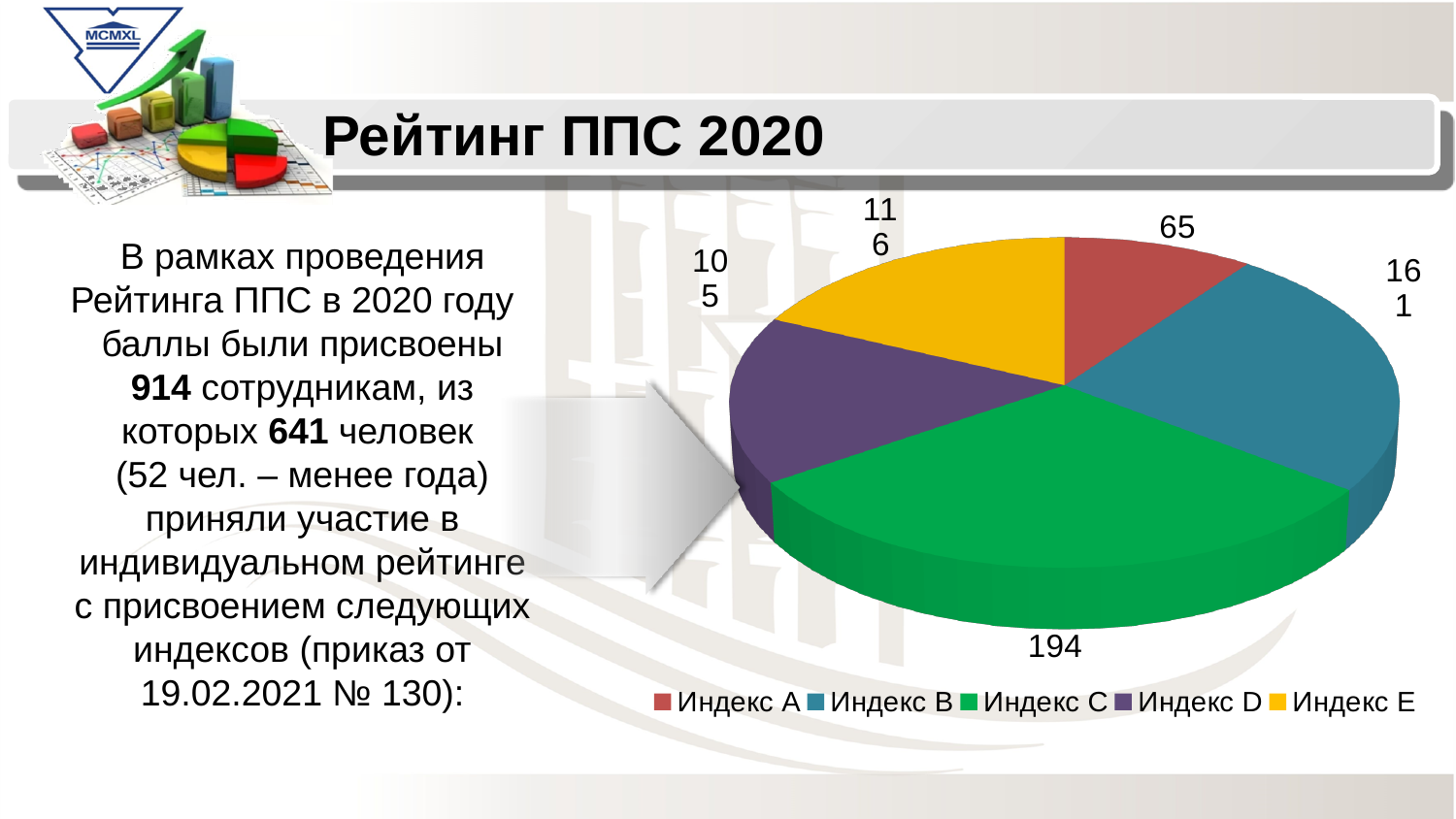
What is the value for Индекс E in the pie chart? 116 Which is larger, the value for Индекс D or the value for Индекс E? Индекс E What is the total of all the values shown in the pie chart? 641 What is the value for Индекс C in the pie chart? 194 What is the difference between the values for Индекс C and Индекс B? 33 What is the value for Индекс B in the pie chart? 161 What is the value for Индекс A in the pie chart? 65 How many slices does the pie chart have? 5 Which index has the largest slice in the pie chart? Индекс C Which index has the smallest slice in the pie chart? Индекс A What colour is the slice for Индекс D in the pie chart? Purple What type of chart is shown on the slide? Pie chart